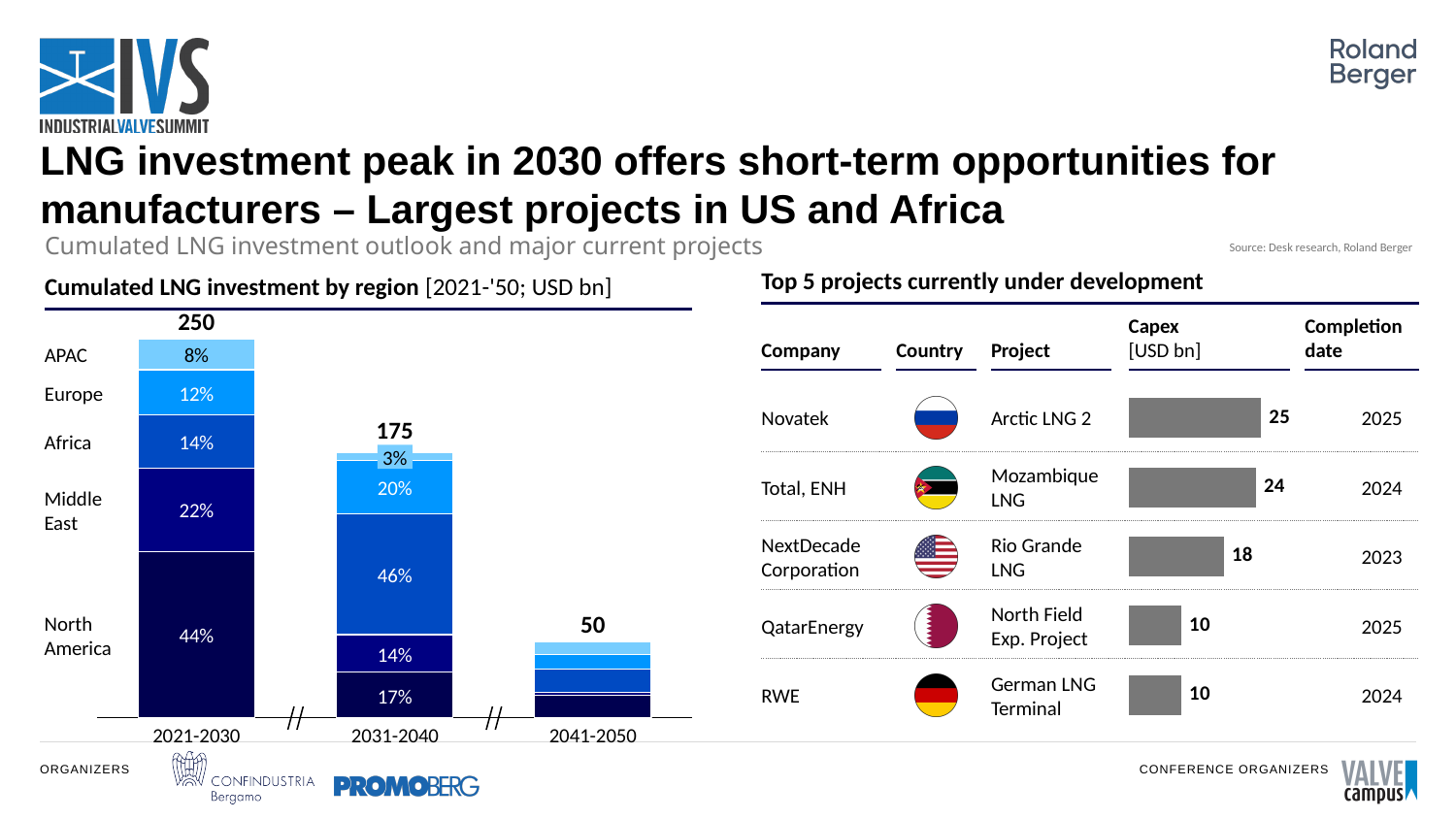
In the 'Cumulated LNG investment by region' chart, what is the total value of the 2041-2050 bar? 50 In the 'Cumulated LNG investment by region' chart, what share does Africa have in the 2031-2040 bar? 46% In the 'Cumulated LNG investment by region' chart, what is the total value of the 2021-2030 bar? 250 In the 'Cumulated LNG investment by region' chart, what is the total value of the 2031-2040 bar? 175 In the 'Cumulated LNG investment by region' chart, what is the difference between the 2021-2030 total and the 2031-2040 total? 75 In the 'Top 5 projects currently under development' table, what is the capex of the Arctic LNG 2 project? 25 In the 'Cumulated LNG investment by region' chart, which period has the highest total investment? 2021-2030 What kind of chart is 'Cumulated LNG investment by region'? Stacked bar chart In the 'Cumulated LNG investment by region' chart, what share does North America have in the 2021-2030 bar? 44% In the 'Cumulated LNG investment by region' chart, do the bar totals rise or fall from 2021-2030 to 2041-2050? Fall In the 'Top 5 projects currently under development' table, which project has the highest capex? Arctic LNG 2 In the 'Cumulated LNG investment by region' chart, what share does the Middle East have in the 2021-2030 bar? 22%